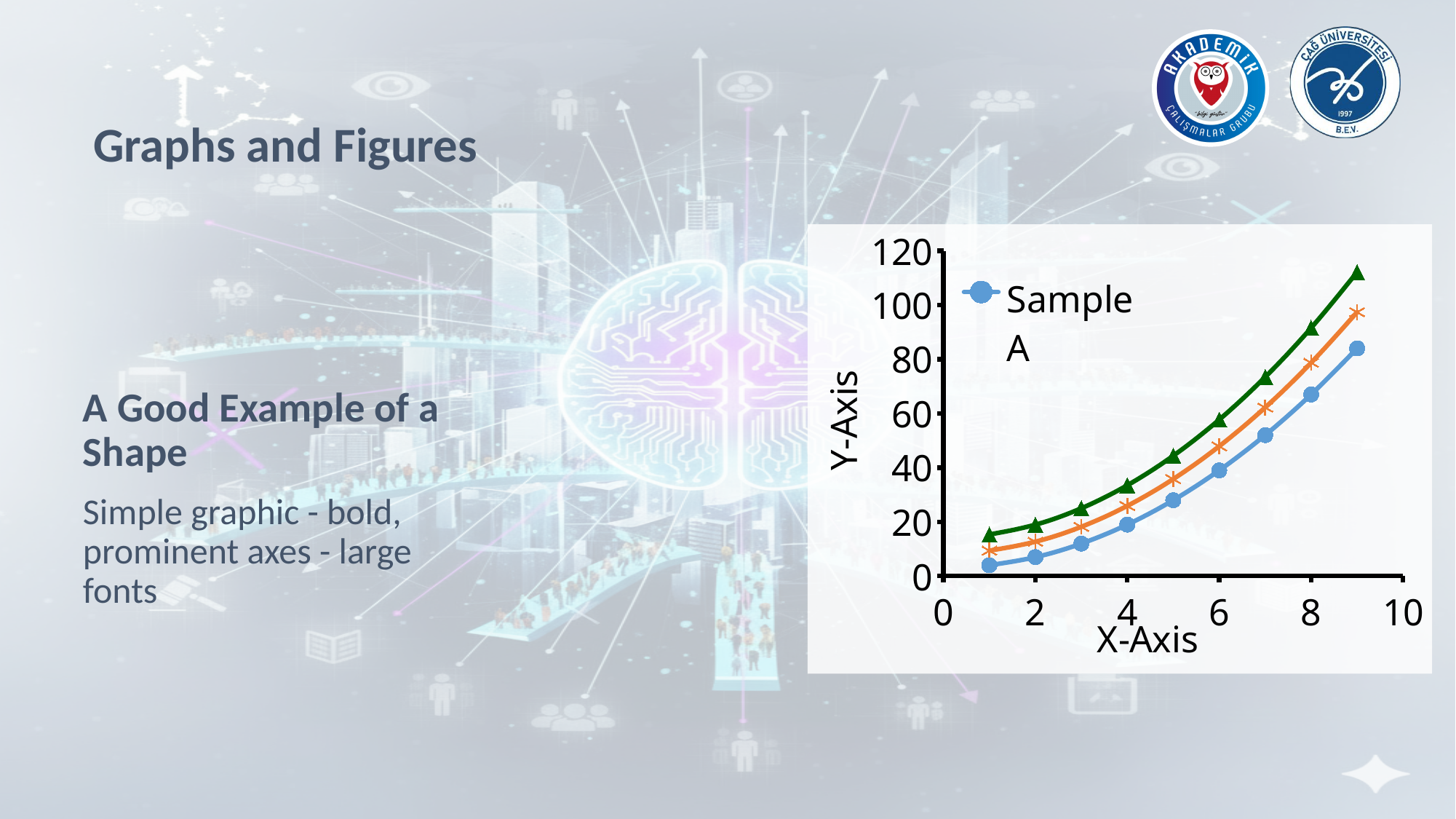
How many lines are plotted on the chart? 3 What is the label of the x axis? X-Axis What is the name of the series listed in the legend? Sample A Is the value of the green triangle series at x = 9 greater or less than 100? greater Is the value of Sample A at x = 1 greater or less than 20? less Is the value of Sample A at x = 9 greater or less than 60? greater How many series does the legend list? 1 At x = 9, which is larger: the green triangle series or Sample A? the green triangle series What kind of chart is shown on the slide? line chart How many data points does the Sample A series have? 9 Do the values of Sample A rise or fall as the x-axis increases? rise